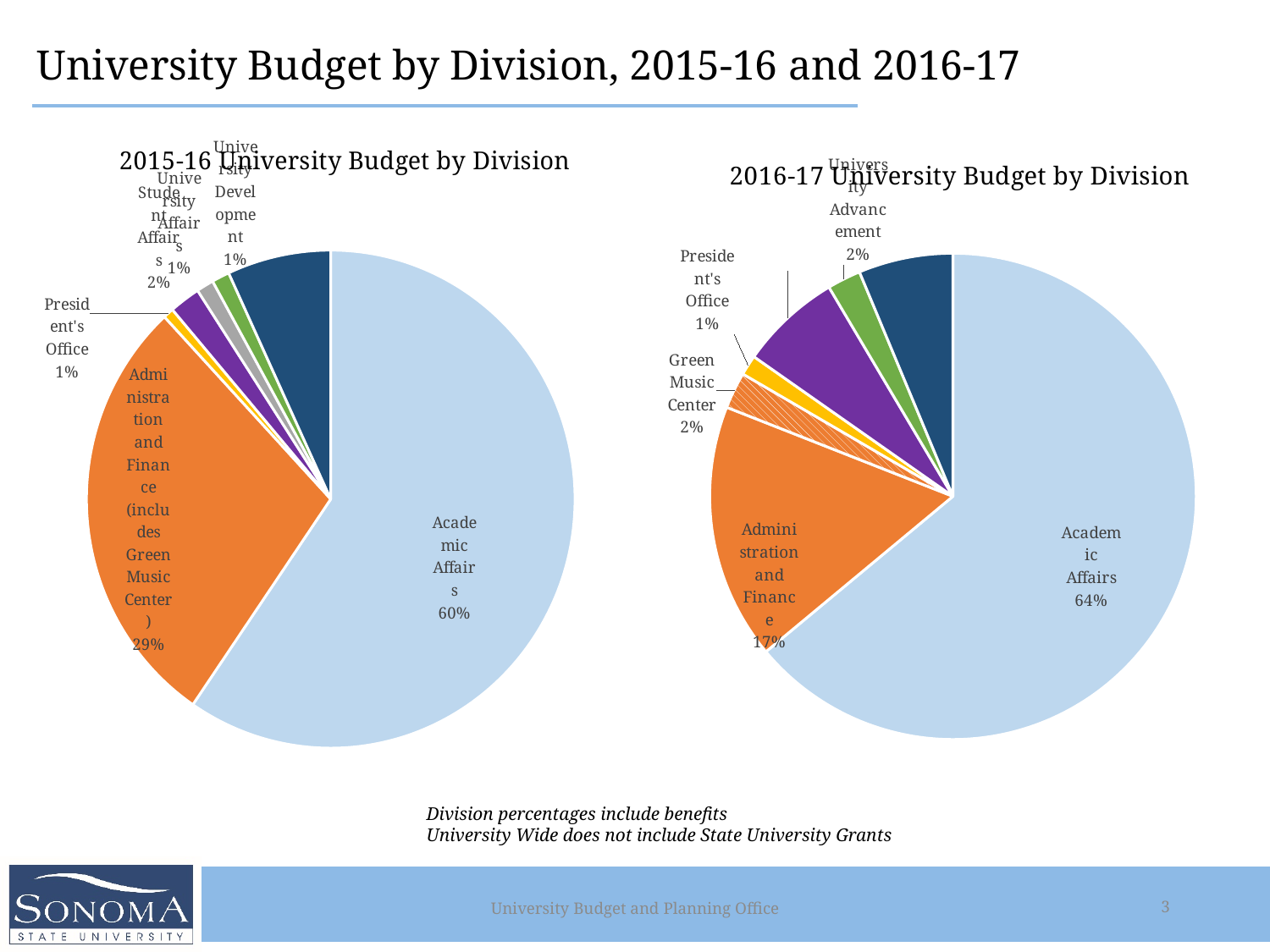
In the 2016-17 University Budget by Division chart, which is larger: the share for Academic Affairs or the share for Administration and Finance? Academic Affairs In the 2016-17 University Budget by Division chart, what percentage is shown for University Advancement? 2% What type of chart is used for the 2015-16 University Budget by Division? Pie chart In the 2016-17 University Budget by Division chart, which division has the largest share of the budget? Academic Affairs In the 2015-16 University Budget by Division chart, what percentage is shown for Administration and Finance (includes Green Music Center)? 29% In the 2015-16 University Budget by Division chart, which division has the largest share of the budget? Academic Affairs In the 2016-17 University Budget by Division chart, what share of the budget goes to Academic Affairs? 64% In the 2015-16 University Budget by Division chart, what percentage is shown for the President's Office? 1% What is the difference in percentage points between the Academic Affairs share in 2016-17 (64%) and in 2015-16 (60%)? 4 percentage points In the 2015-16 University Budget by Division chart, what share of the budget goes to Academic Affairs? 60% In the 2016-17 University Budget by Division chart, what percentage is shown for Administration and Finance? 17% In the 2016-17 University Budget by Division chart, what percentage is shown for the Green Music Center? 2%